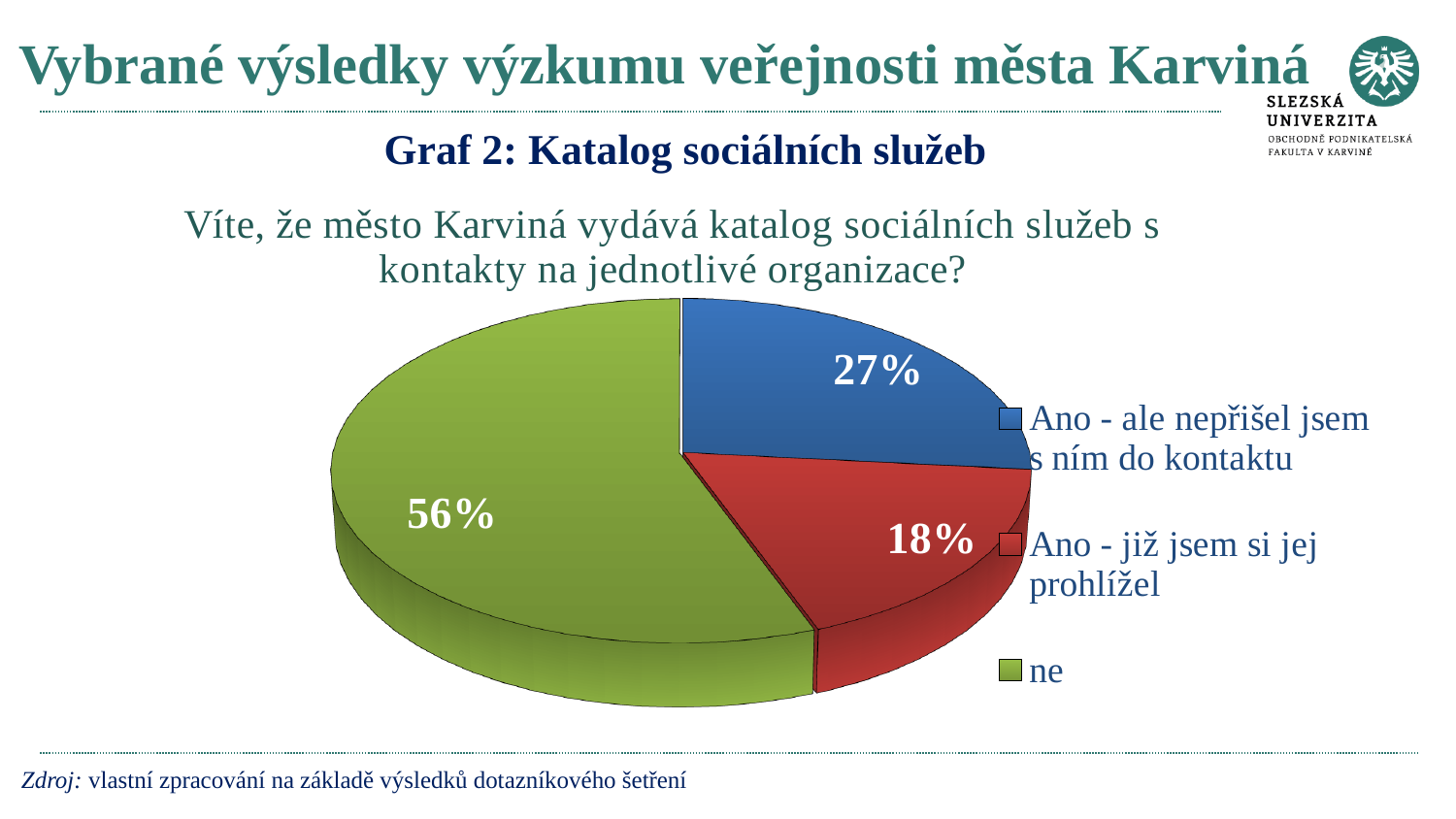
How many categories does the pie chart have? 3 What is the difference in percentage points between the "ne" slice and the "Ano - ale nepřišel jsem s ním do kontaktu" slice? 29 What is the title of the chart? Víte, že město Karviná vydává katalog sociálních služeb s kontakty na jednotlivé organizace? What is the difference in percentage points between the "Ano - ale nepřišel jsem s ním do kontaktu" slice and the "Ano - již jsem si jej prohlížel" slice? 9 What percentage is shown for "Ano - již jsem si jej prohlížel"? 18% What kind of chart is shown on the slide? pie chart What share of the pie does the "ne" slice represent? 56% Which category has the smallest slice of the pie? Ano - již jsem si jej prohlížel What percentage is shown for "Ano - ale nepřišel jsem s ním do kontaktu"? 27% Which category has the largest slice of the pie? ne What colour is the "ne" slice of the pie? green Which is larger: the share for "Ano - ale nepřišel jsem s ním do kontaktu" or for "Ano - již jsem si jej prohlížel"? Ano - ale nepřišel jsem s ním do kontaktu